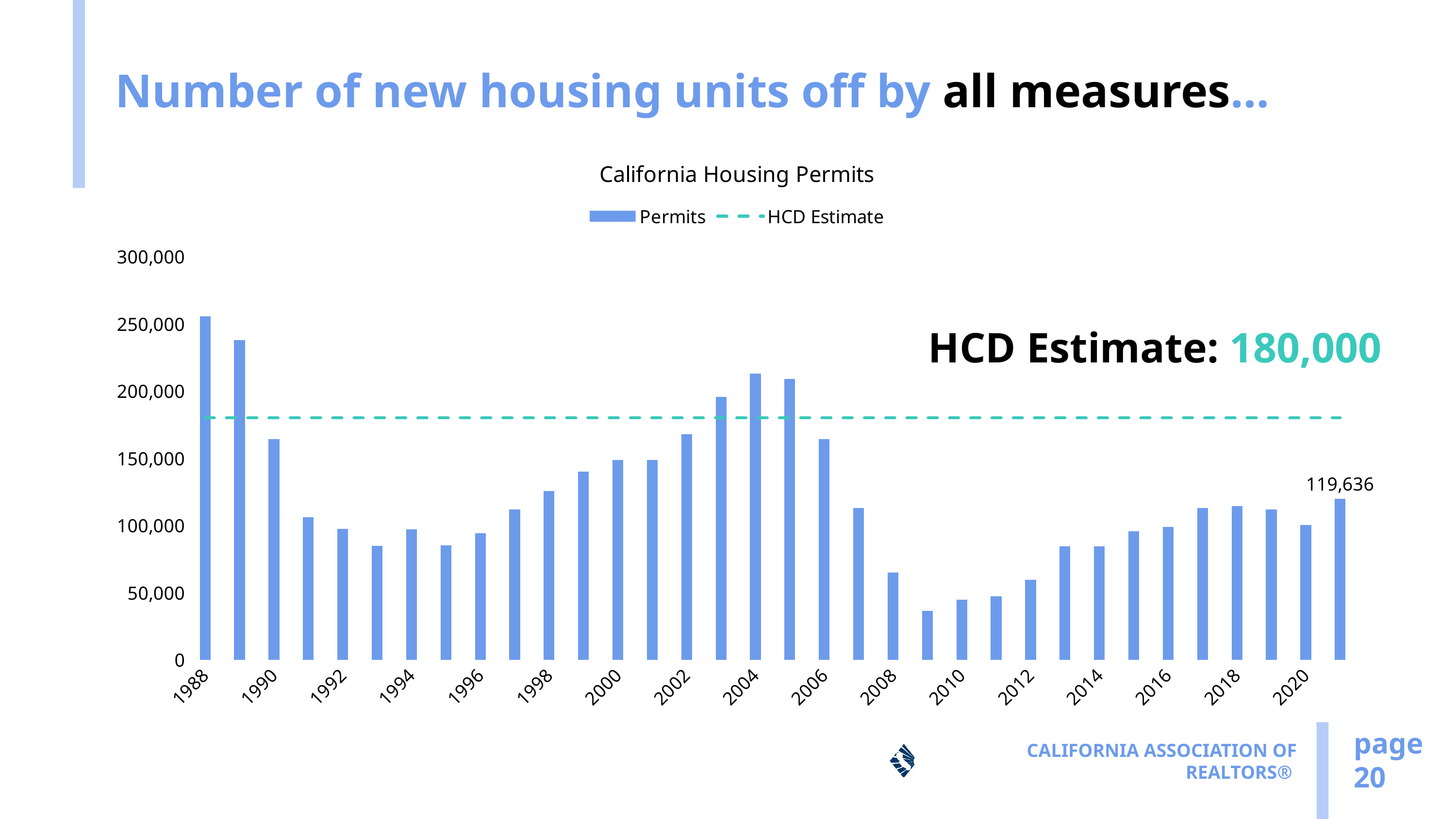
Is the value for 2004 greater or less than 200,000? greater What kind of chart is used to show the permits data? Bar chart What is the value printed on the data label for the last bar (2021) in the California Housing Permits chart? 119,636 Which year has the highest number of permits in the California Housing Permits chart? 1988 Which year has more permits, 2009 or 2021? 2021 What is the HCD Estimate value shown on the slide? 180,000 Is the value for 1990 greater or less than 150,000? greater Which year has more permits, 1988 or 2004? 1988 How many series does the legend of the California Housing Permits chart list? 2 Do the permit values rise or fall from 2005 to 2009? Fall Is the value for 2009 greater or less than 50,000? less Which year has the lowest number of permits in the California Housing Permits chart? 2009